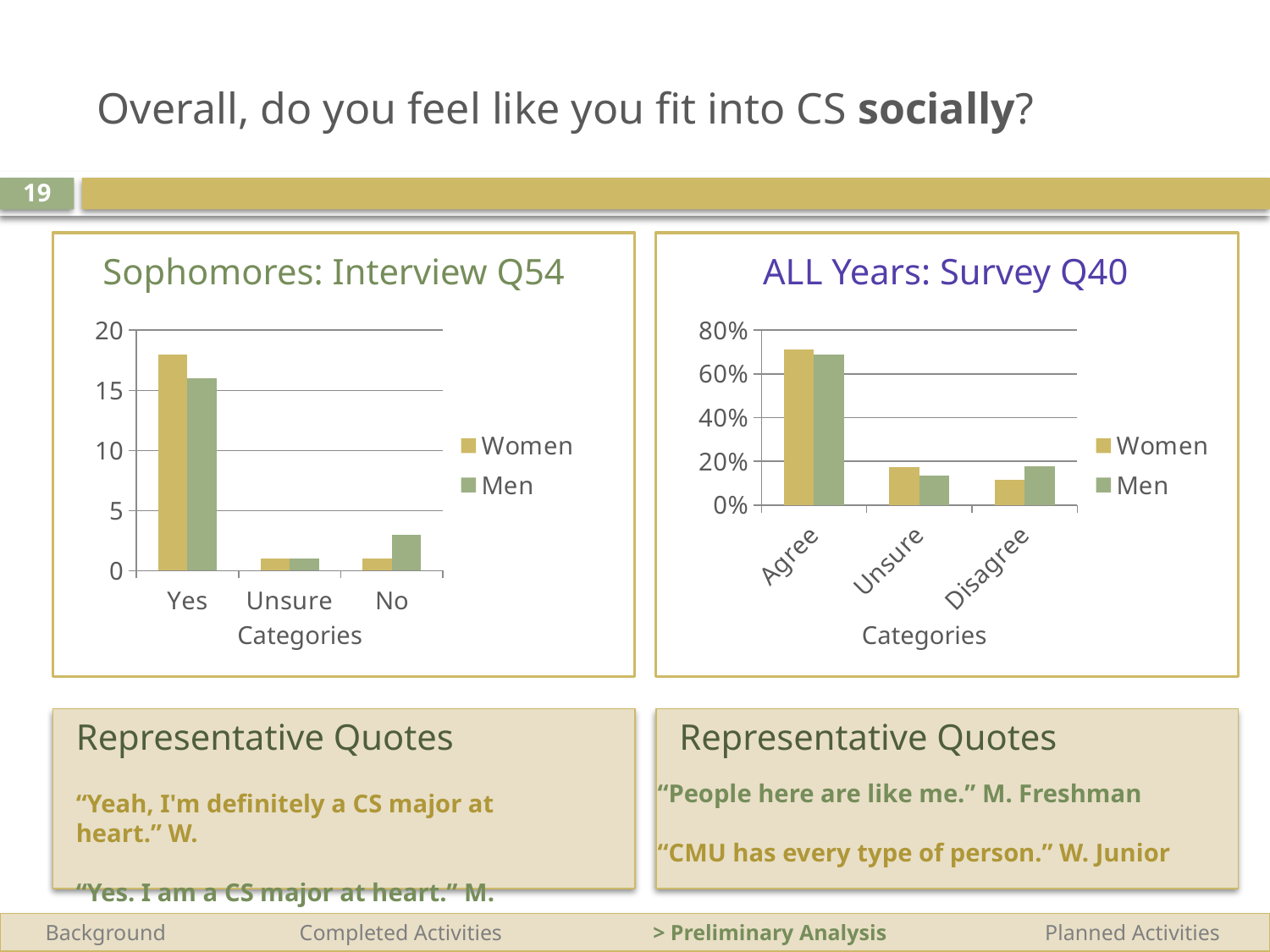
In the "Sophomores: Interview Q54" chart, is the value for Men in the No category greater or less than 5? less What are the two legend entries in the "ALL Years: Survey Q40" chart? Women and Men In the "ALL Years: Survey Q40" chart, in the Disagree category, which series has the larger value, Women or Men? Men How many series does the legend of the "Sophomores: Interview Q54" chart list? 2 In the "Sophomores: Interview Q54" chart, in the No category, which series has the larger value, Women or Men? Men In the "Sophomores: Interview Q54" chart, which category has the lowest value for Men? Unsure In the "ALL Years: Survey Q40" chart, is the value for Women in the Agree category greater or less than 60%? greater How many categories are shown on the x axis of the "ALL Years: Survey Q40" chart? 3 What type of chart is the "Sophomores: Interview Q54" chart? bar chart In the "Sophomores: Interview Q54" chart, which category has the highest value for Women? Yes In the "Sophomores: Interview Q54" chart, is the value for Women in the Yes category greater or less than 15? greater In the "ALL Years: Survey Q40" chart, which category has the lowest value for Women? Disagree